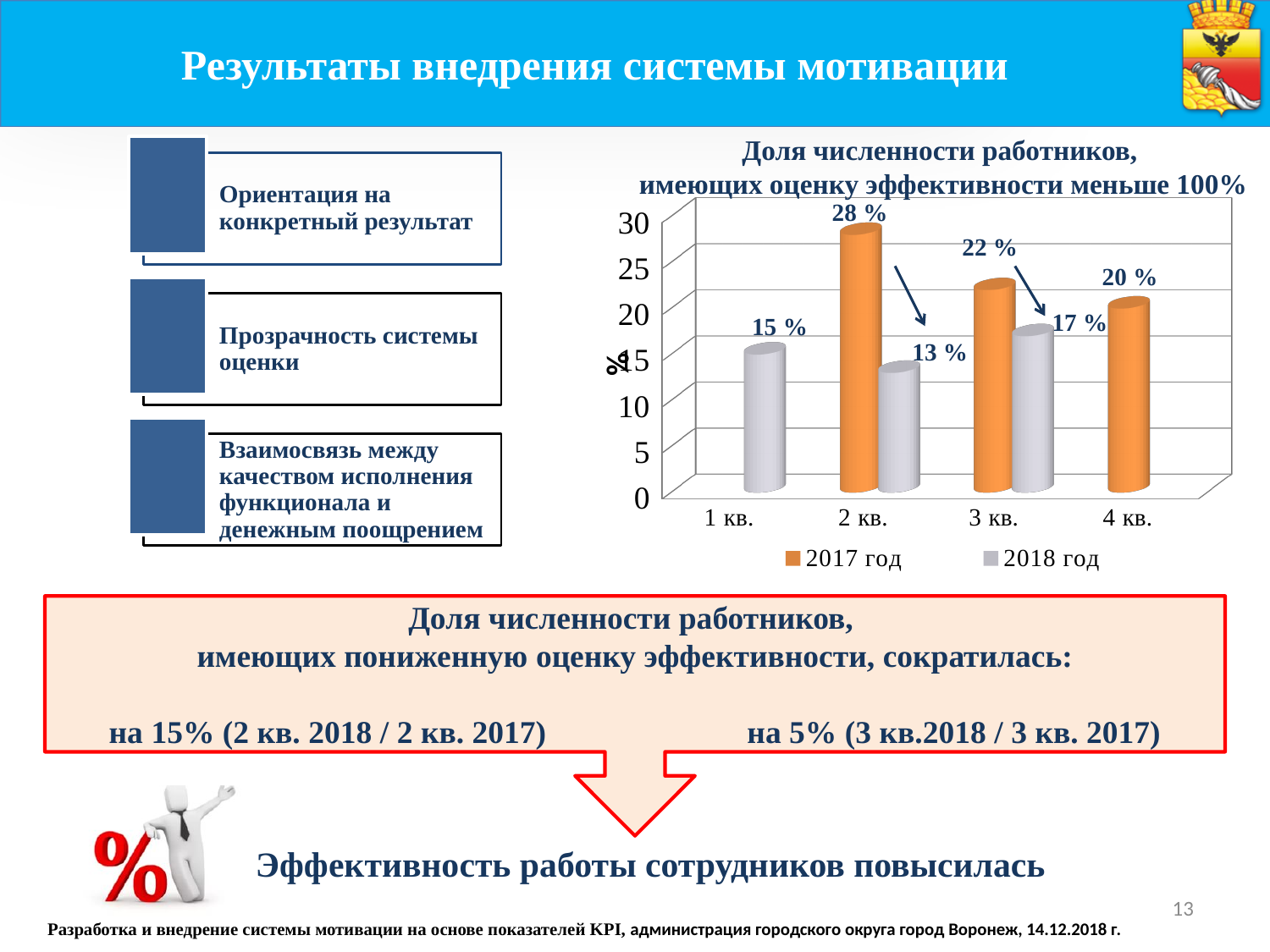
Which is larger in 3 кв.: the 2017 год value or the 2018 год value? 2017 год Which quarter has the lowest value for 2018 год? 2 кв. How many quarters are shown on the x axis? 4 What is the value for 2017 год in 4 кв.? 20 % Which colour represents 2017 год in the chart? Orange Which quarter has the highest value for 2017 год? 2 кв. What is the value for 2018 год in 3 кв.? 17 % How many series does the legend list? 2 What is the difference between the 2017 год and 2018 год values in 2 кв.? 15 % What is the value for 2018 год in 1 кв.? 15 % What is the value for 2017 год in 2 кв.? 28 % What kind of chart is shown on the slide? Bar chart